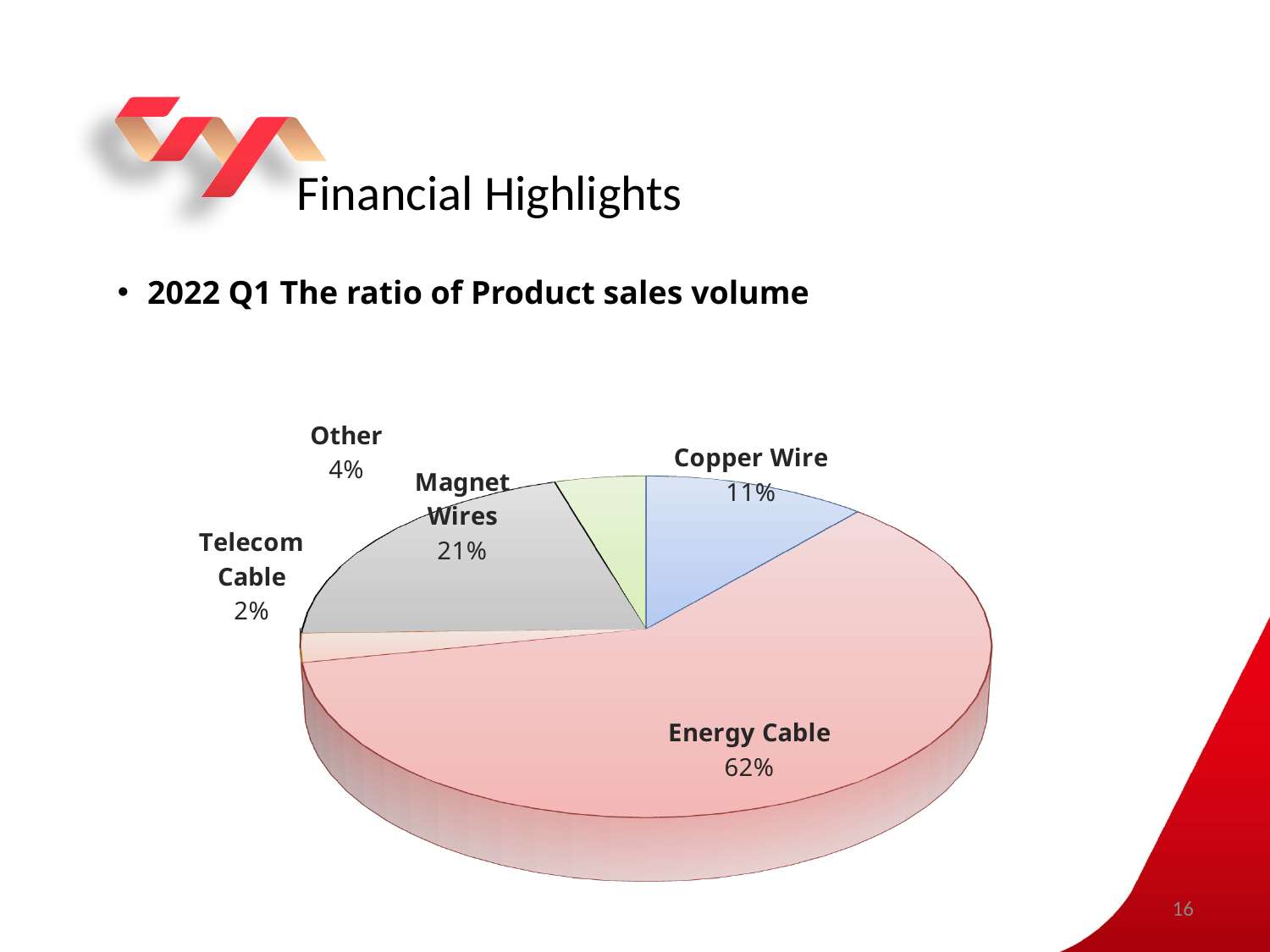
What percentage is shown for Copper Wire? 11% What percentage is shown for Magnet Wires? 21% What kind of chart is shown on the slide? Pie chart What is the difference in percentage points between Energy Cable and Magnet Wires? 41 Which product category has the smallest share of sales volume? Telecom Cable What percentage is shown for Telecom Cable? 2% Which product category has the largest share of sales volume? Energy Cable What share of product sales volume does Energy Cable account for? 62% What percentage is shown for Other? 4% How many product categories are shown in the pie chart? 5 What period does the chart of product sales volume ratio refer to? 2022 Q1 Which has a larger share, Copper Wire or Magnet Wires? Magnet Wires